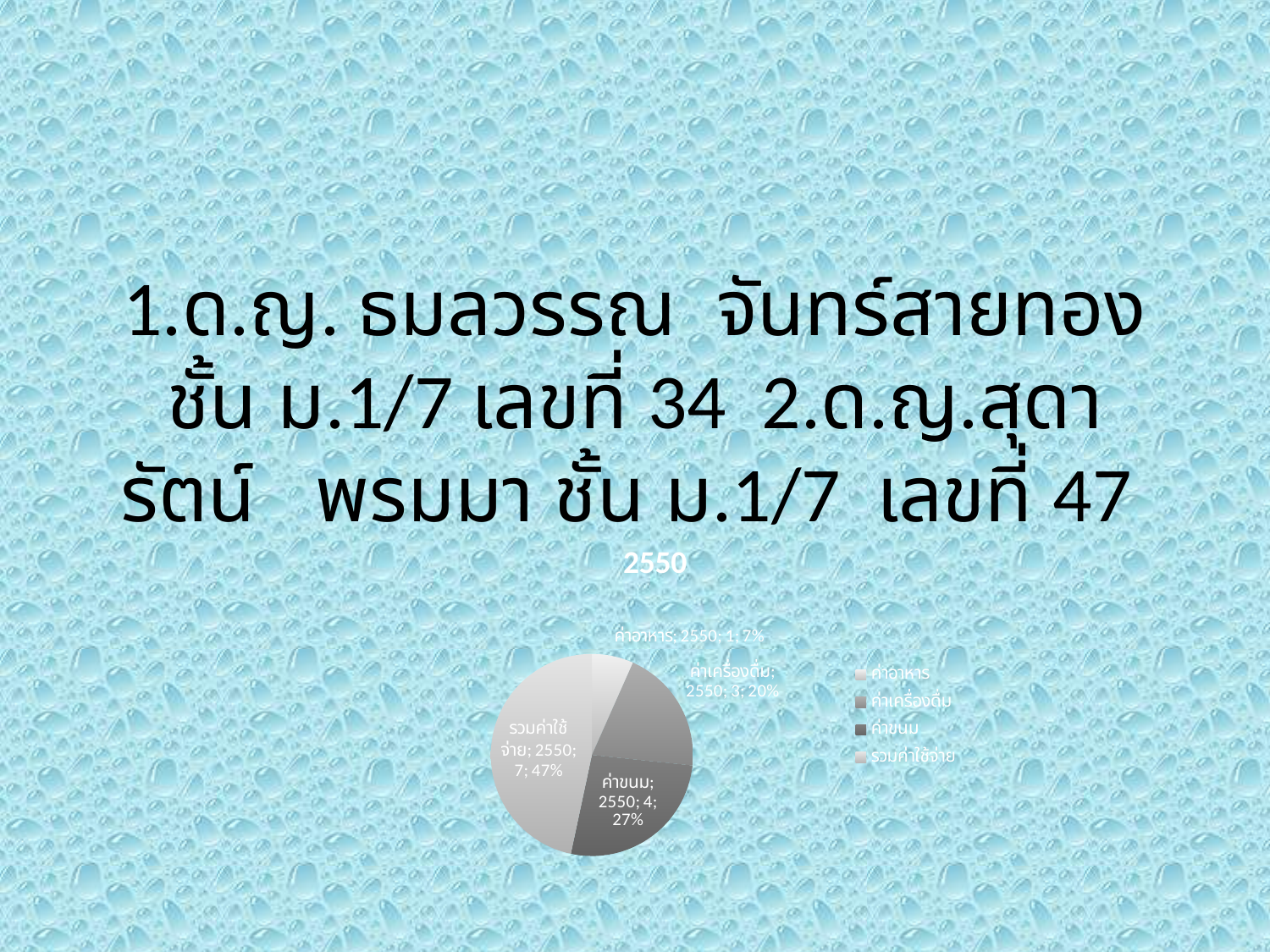
What share of the pie does ค่าขนม take? 27% Which category has the largest slice? รวมค่าใช้จ่าย What share of the pie does รวมค่าใช้จ่าย take? 47% Which category has the smallest slice? ค่าอาหาร What is the value for ค่าเครื่องดื่ม? 3 What is the title of the chart? 2550 What is the value for รวมค่าใช้จ่าย? 7 What is the value for ค่าอาหาร? 1 How many entries does the legend list? 4 What kind of chart is shown on the slide? pie chart What is the value for ค่าขนม? 4 How many slices does the pie chart have? 4